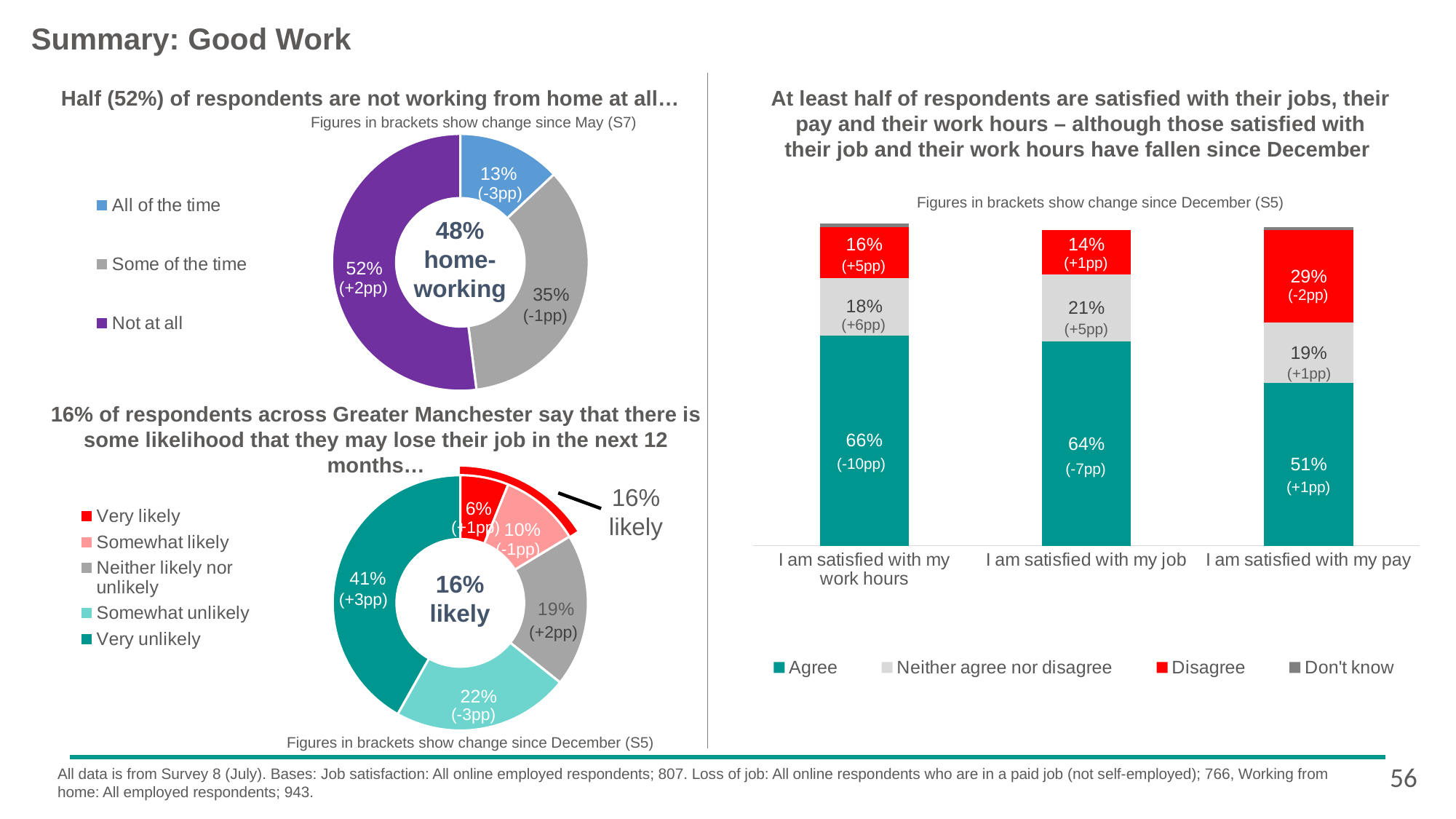
In the top-left donut chart about working from home, what percentage of respondents are 'Not at all' working from home? 52% In the bottom-left donut chart about likelihood of losing their job, what percentage of respondents say 'Very unlikely'? 41% In the right-hand stacked bar chart on job satisfaction, which statement has the highest 'Disagree' percentage? I am satisfied with my pay In the bottom-left donut chart about likelihood of losing their job, what is the difference between the 'Somewhat unlikely' share and the 'Somewhat likely' share? 12 percentage points How many categories does the top-left donut chart about working from home show? 3 In the right-hand stacked bar chart on job satisfaction, what percentage agree with 'I am satisfied with my pay'? 51% How many series does the legend of the right-hand stacked bar chart on job satisfaction list? 4 In the right-hand stacked bar chart on job satisfaction, what is the difference between the 'Agree' percentage for 'I am satisfied with my work hours' and for 'I am satisfied with my job'? 2 percentage points In the top-left donut chart about working from home, which category has the smallest share? All of the time In the bottom-left donut chart about likelihood of losing their job, which is larger: 'Neither likely nor unlikely' or 'Somewhat likely'? Neither likely nor unlikely What kind of chart is the bottom-left chart about likelihood of losing their job? Donut (pie) chart In the right-hand stacked bar chart on job satisfaction, what change since December is shown in brackets for the 'Agree' segment of 'I am satisfied with my work hours'? -10pp